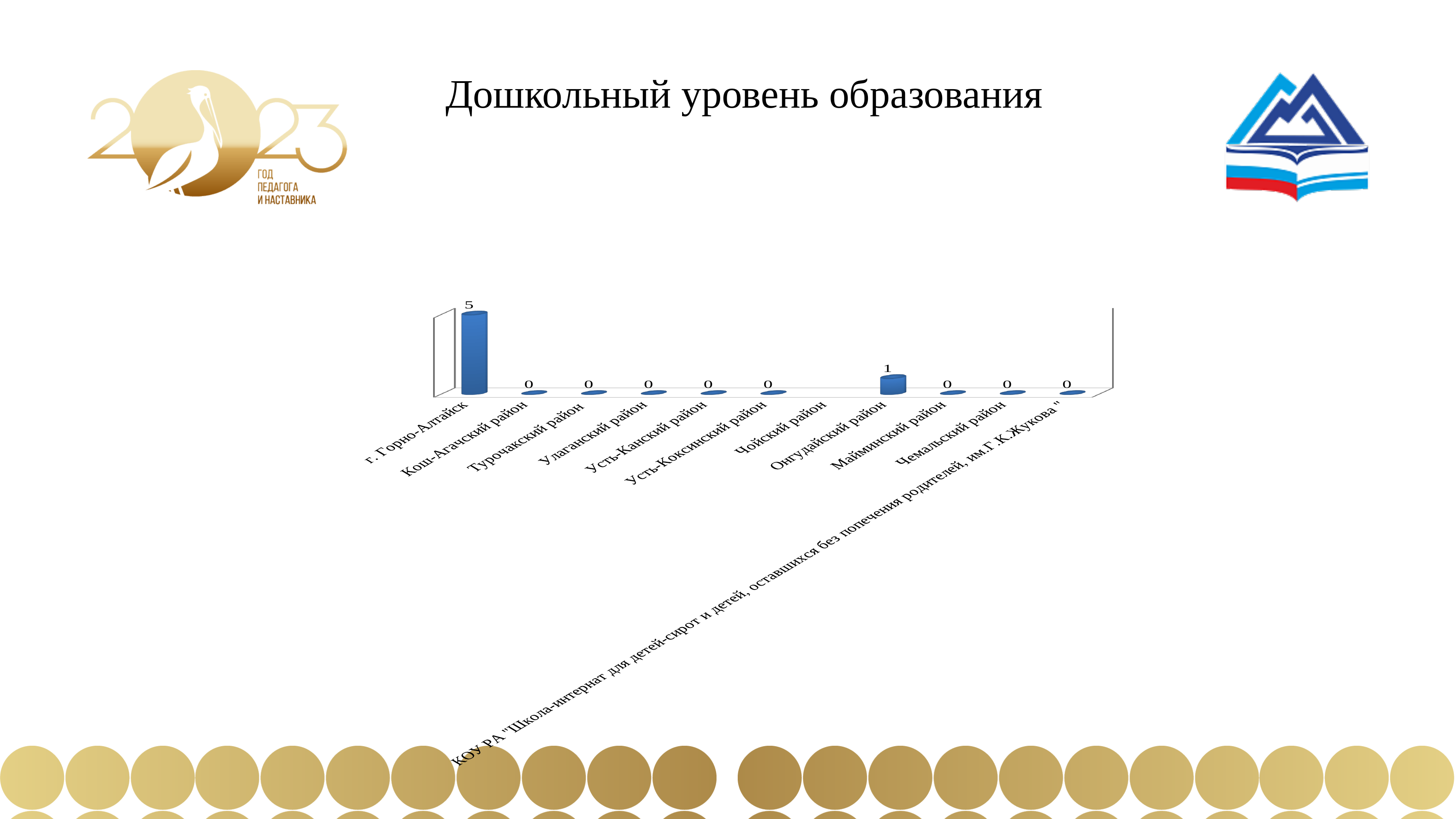
How many categories are shown on the x axis? 11 What is the difference between the values for г. Горно-Алтайск and Онгудайский район? 4 How many categories have a value of 0? 8 Which category has the highest value? г. Горно-Алтайск Which is larger, the value for Онгудайский район or the value for Чемальский район? Онгудайский район What is the value for Онгудайский район? 1 What is the value for Майминский район? 0 What is the total of all the values shown in the chart? 6 What is the title of the slide containing the chart? Дошкольный уровень образования What kind of chart is shown on the slide? bar chart What is the value for г. Горно-Алтайск? 5